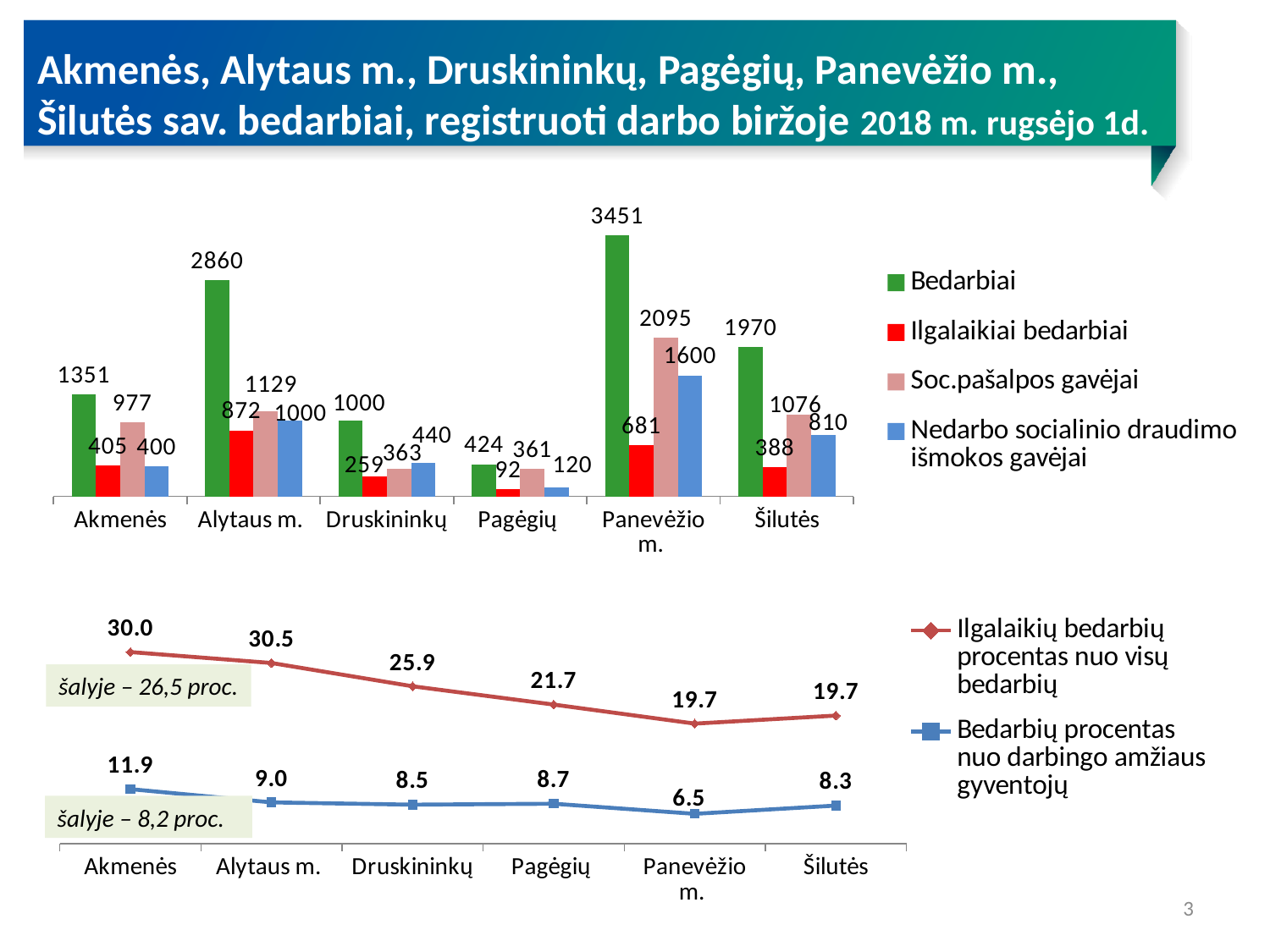
What type of chart is the top chart on the slide? bar chart In the top bar chart, what is the difference between the Soc.pašalpos gavėjai values for Panevėžio m. and Šilutės? 1019 How many series does the legend of the top bar chart list? 4 In the bottom line chart, how many municipalities are plotted along the x axis? 6 In the top bar chart, what is the Ilgalaikiai bedarbiai value for Alytaus m.? 872 In the bottom line chart, what is the difference between the Ilgalaikių bedarbių procentas values for Alytaus m. and Pagėgių? 8.8 In the top bar chart, which municipality has the lowest Bedarbiai value? Pagėgių In the top bar chart, what is the Bedarbiai value for Panevėžio m.? 3451 In the top bar chart, which is larger for Druskininkų: Soc.pašalpos gavėjai or Nedarbo socialinio draudimo išmokos gavėjai? Nedarbo socialinio draudimo išmokos gavėjai In the bottom line chart, what is the Ilgalaikių bedarbių procentas nuo visų bedarbių value for Druskininkų? 25.9 In the bottom line chart, which municipality has the highest Bedarbių procentas nuo darbingo amžiaus gyventojų? Akmenės In the bottom line chart, which municipality has the lowest Bedarbių procentas nuo darbingo amžiaus gyventojų? Panevėžio m.